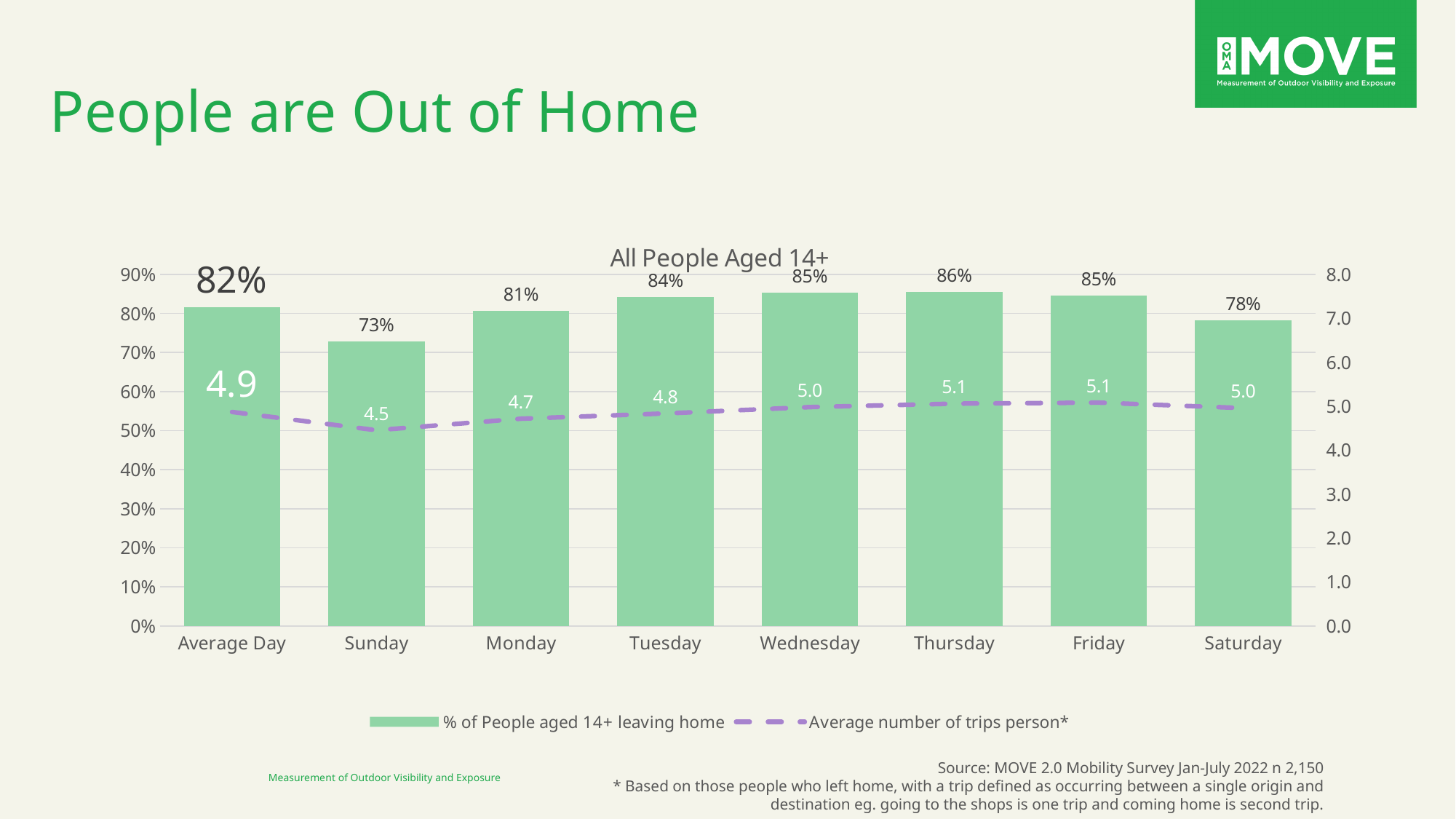
Which day has the lowest average number of trips per person? Sunday Which is larger, the percentage of people leaving home on Monday or on Saturday? Monday Which day has the lowest percentage of people aged 14+ leaving home? Sunday What is the difference in the percentage of people leaving home between Thursday and Sunday? 13% What is the chart's title? All People Aged 14+ What is the average number of trips per person on Thursday? 5.1 What is the average number of trips per person on an Average Day? 4.9 What percentage of people aged 14+ left home on Sunday? 73% Which day has the highest percentage of people aged 14+ leaving home? Thursday How many categories are shown on the x axis? 8 What kind of chart is used to show the percentage of people aged 14+ leaving home? Bar chart How many series does the legend list? 2